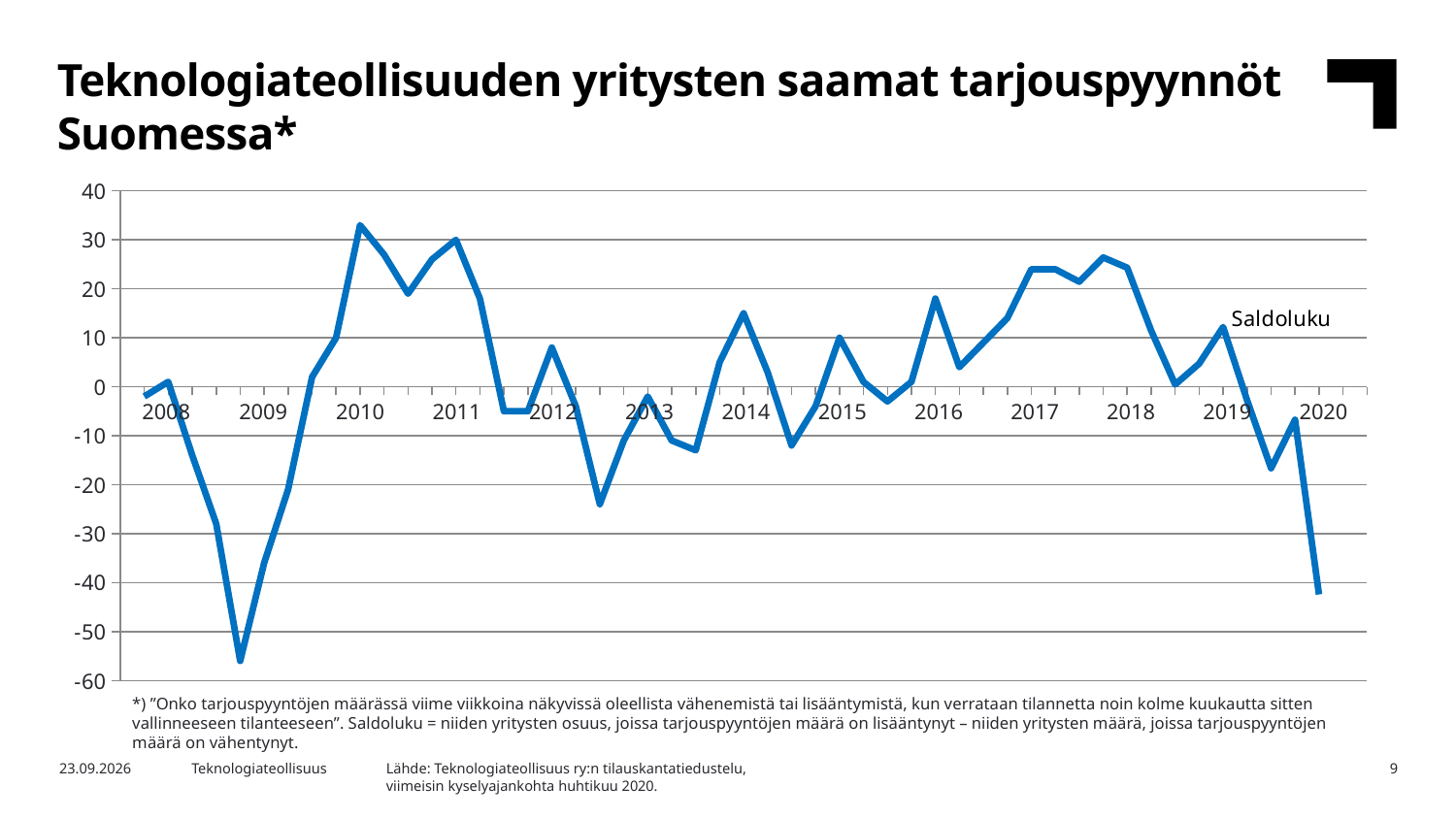
Does the line rise or fall between 2009 and 2010? rise What is the name of the series labelled on the chart? Saldoluku Is the lowest value of the line, reached between 2008 and 2009, greater or less than -50? less Which is larger: the peak of the line around 2010 or the peak around 2016? the peak around 2010 Is the peak value of the line around 2018 greater or less than 20? greater How many data series does the chart plot? 1 Is the peak value of the line around 2010 greater or less than 30? greater Does the line rise or fall between 2019 and 2020? fall What is the title of the chart on the slide? Teknologiateollisuuden yritysten saamat tarjouspyynnöt Suomessa* What kind of chart is shown on the slide? line chart